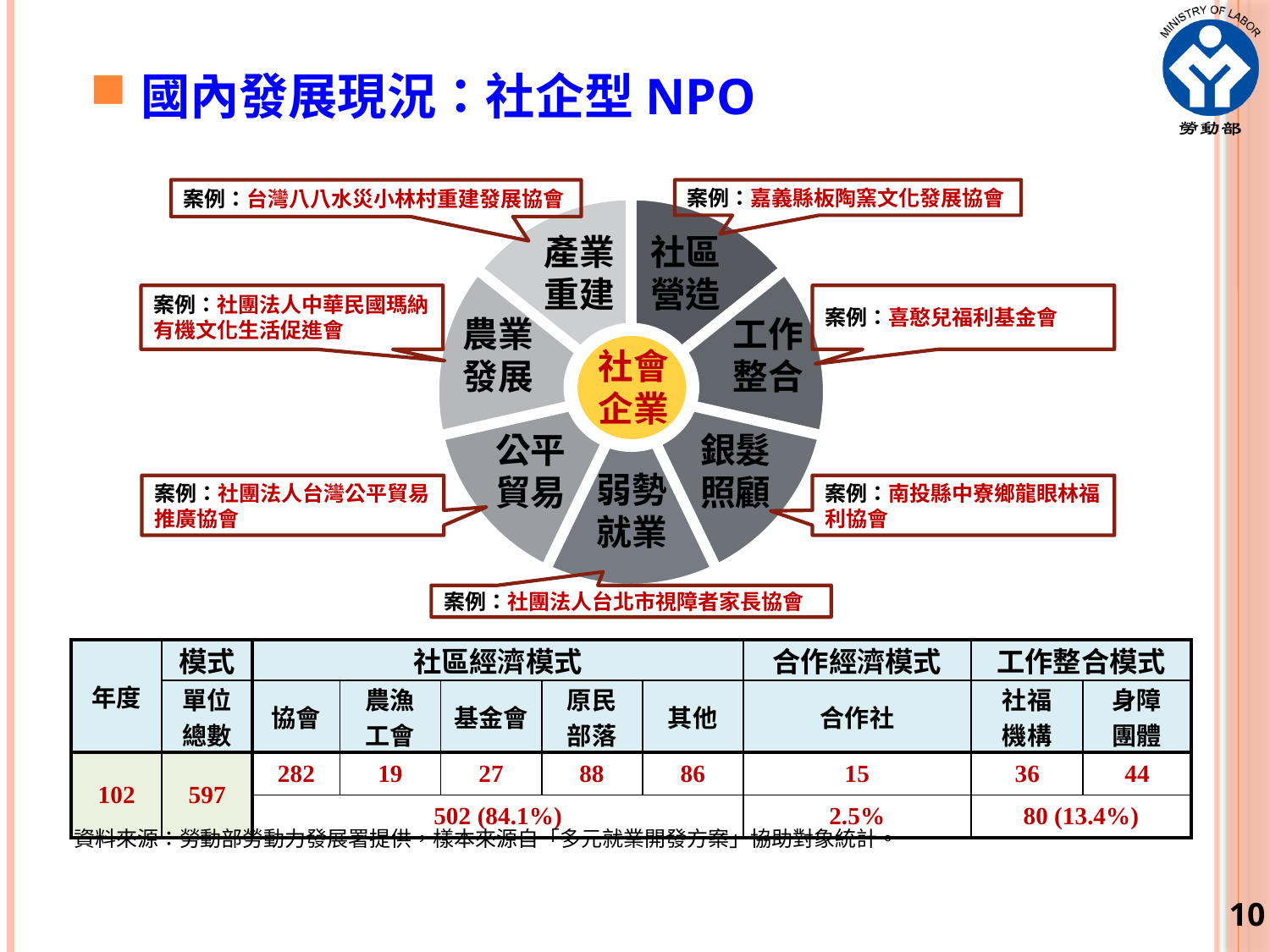
In the table at the bottom of the slide, what is the value for 合作社? 15 In the table at the bottom of the slide, what percentage is shown for 合作經濟模式? 2.5% How many segments surround the central 社會企業 circle in the wheel diagram? 7 In the table at the bottom of the slide, which category has the highest number of units? 協會 In the table at the bottom of the slide, what is the value shown for 身障團體? 44 In the table at the bottom of the slide, what is the total number of units (單位總數) for year 102? 597 In the table at the bottom of the slide, what is the difference between the 協會 value and the 農漁工會 value? 263 In the table at the bottom of the slide, what is the number of 協會 units for year 102? 282 In the table at the bottom of the slide, which category has the lowest number of units? 合作社 In the table at the bottom of the slide, what is the subtotal and percentage shown for 社區經濟模式? 502 (84.1%) In the table at the bottom of the slide, which is larger, the value for 原民部落 or the value for 其他? 原民部落 In the table at the bottom of the slide, what is the difference between 身障團體 and 社福機構? 8